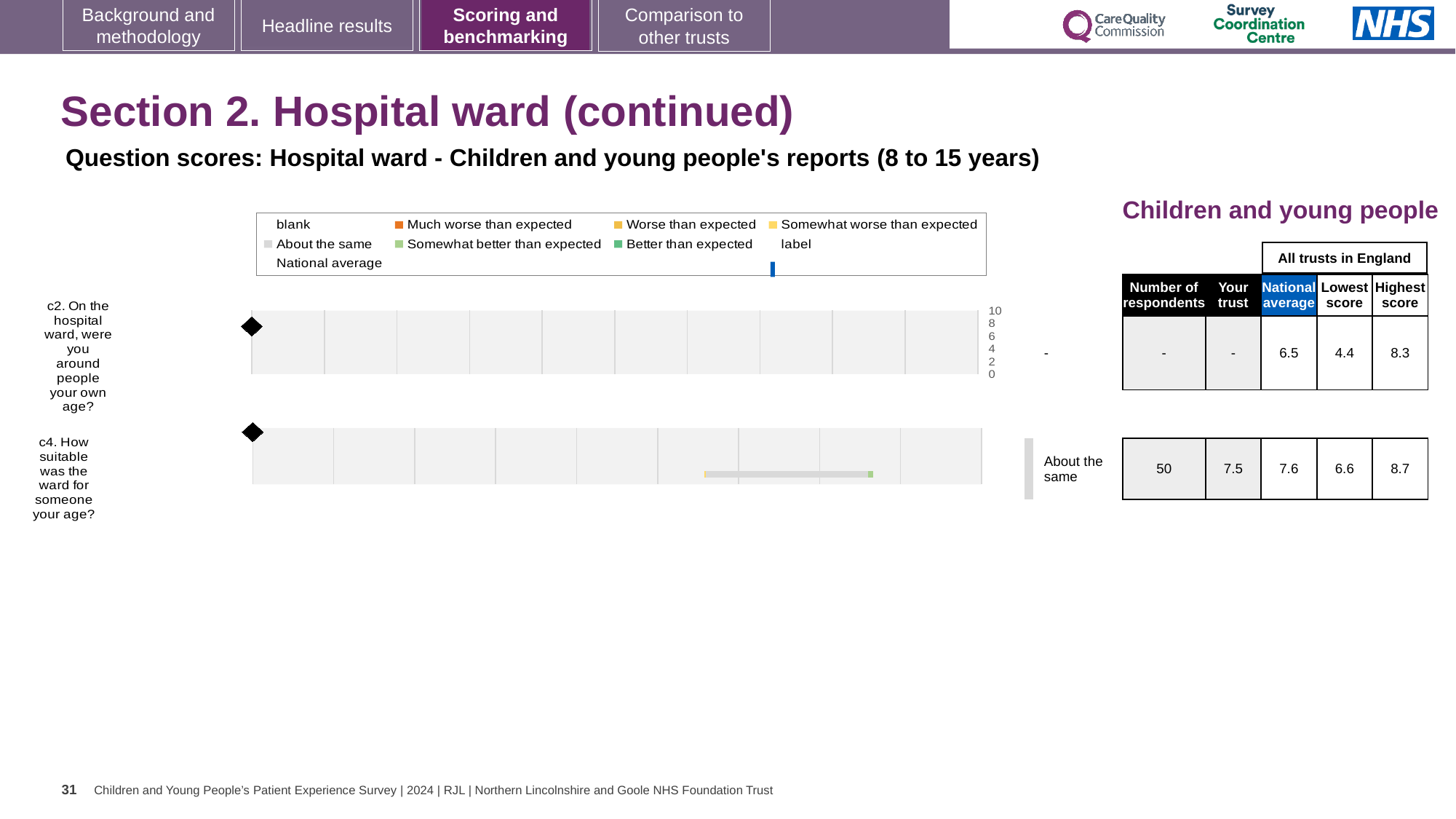
What benchmark category is shown for question c4 'How suitable was the ward for someone your age?'? About the same What is the highest score among all trusts in England for question c2 'On the hospital ward, were you around people your own age?'? 8.3 Which is larger for question c4: the trust's own score or the national average? National average How many respondents answered question c4 'How suitable was the ward for someone your age?'? 50 What is the 'Your trust' score for question c4 'How suitable was the ward for someone your age?'? 7.5 What is the difference between the highest and lowest trust scores for question c4 'How suitable was the ward for someone your age?'? 2.1 What is the national average score for question c4 'How suitable was the ward for someone your age?'? 7.6 What kind of chart is used to show the question scores on this slide? Bar chart Which question has the higher national average score, c2 or c4? c4 What is the maximum value shown on the score axis of the charts? 10 What is the lowest score among all trusts in England for question c2 'On the hospital ward, were you around people your own age?'? 4.4 How many survey questions are plotted on the slide? 2